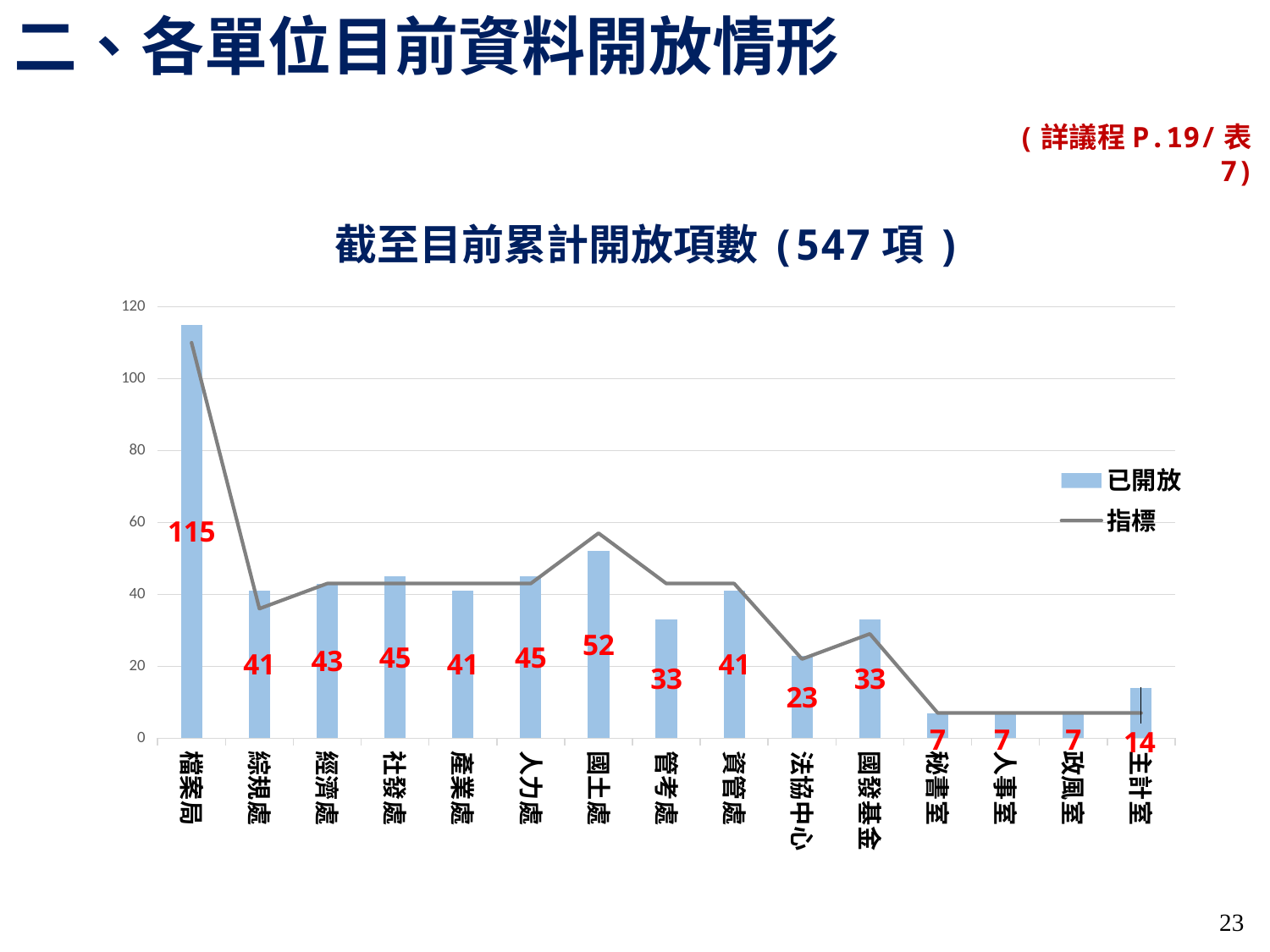
Is the 指標 value for 法協中心 greater or less than 40? less What is the title of the chart? 截至目前累計開放項數（547 項） Which has a larger 已開放 value, 社發處 or 管考處? 社發處 Is the 指標 value for 檔案局 greater or less than 100? greater What is the difference between the 已開放 values for 檔案局 and 國土處? 63 What is the 已開放 value for 法協中心? 23 What is the 已開放 value for 檔案局? 115 How many series does the legend list? 2 What is the lowest 已開放 value shown on the chart? 7 Which unit has the highest 已開放 value? 檔案局 How many units are shown on the x axis of the chart? 15 What is the 已開放 value for 國土處? 52